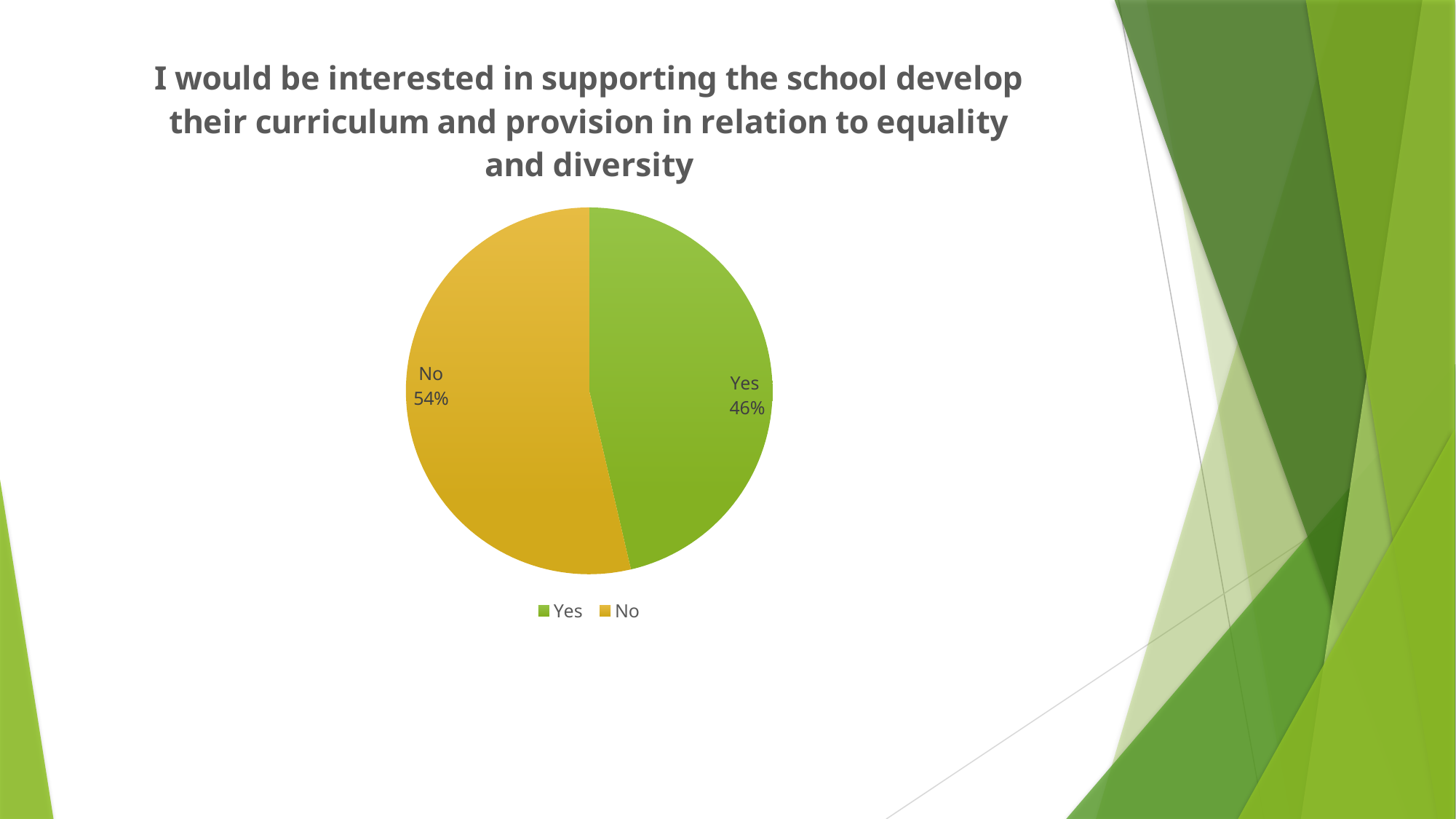
What kind of chart is shown on the slide? pie chart Is the share for Yes larger or smaller than the share for No? smaller How many slices does the pie chart have? 2 Which response has the larger share of the pie? No What is the difference in percentage points between the No and Yes slices? 8 percentage points What colour is the Yes slice? green What is the title of the chart? I would be interested in supporting the school develop their curriculum and provision in relation to equality and diversity What share of the pie does the No slice represent? 54% Which response has the smaller share of the pie? Yes What percentage of respondents answered Yes? 46% How many entries does the legend list? 2 What percentage of respondents answered No? 54%